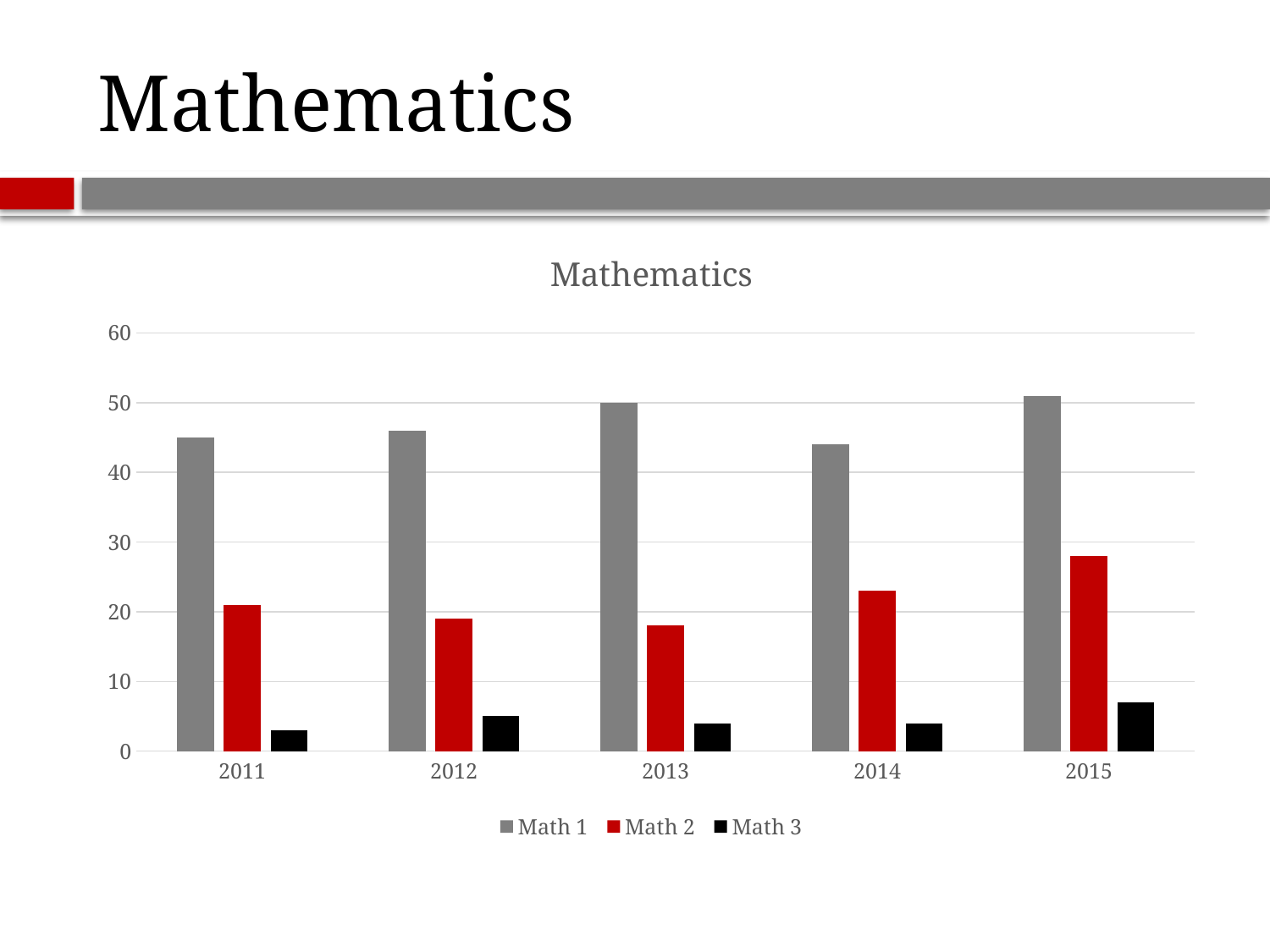
Is the value for Math 1 in 2011 greater or less than 40? greater Is the value for Math 2 in 2015 greater or less than 20? greater Which series is drawn in red? Math 2 How many years are shown on the x axis? 5 Which is larger in 2014, Math 1 or Math 2? Math 1 What is the title of the chart? Mathematics Is the value for Math 3 in 2015 greater or less than 10? less What kind of chart is shown on the slide? bar chart In which year is Math 3 highest? 2015 In which year is Math 2 highest? 2015 How many series does the legend list? 3